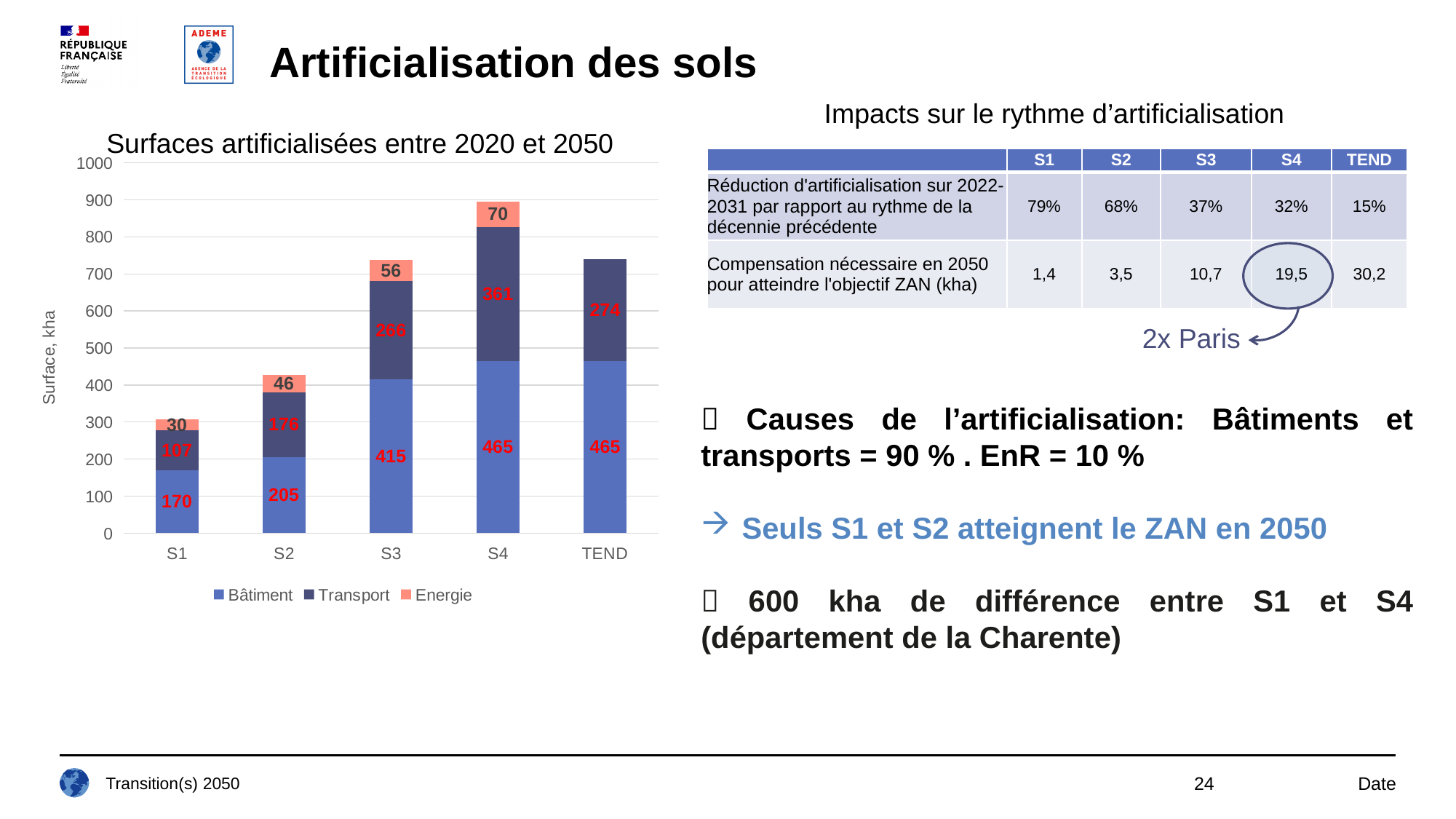
Which scenario has the lowest Energie value? S1 What is the difference between the Transport values for S4 and S1? 254 What is the Transport value for S4? 361 What is the Energie value for S2? 46 Which scenario has the highest Bâtiment value among S1, S2 and S3? S3 How many series does the legend list? 3 How many scenarios are shown on the x axis? 5 Is the Bâtiment value larger for S2 or for S1? S2 What is the Bâtiment value for S3? 415 What is the total of the stacked bar for S4? 896 What is the Transport value for TEND? 274 What kind of chart is 'Surfaces artificialisées entre 2020 et 2050'? Stacked bar chart